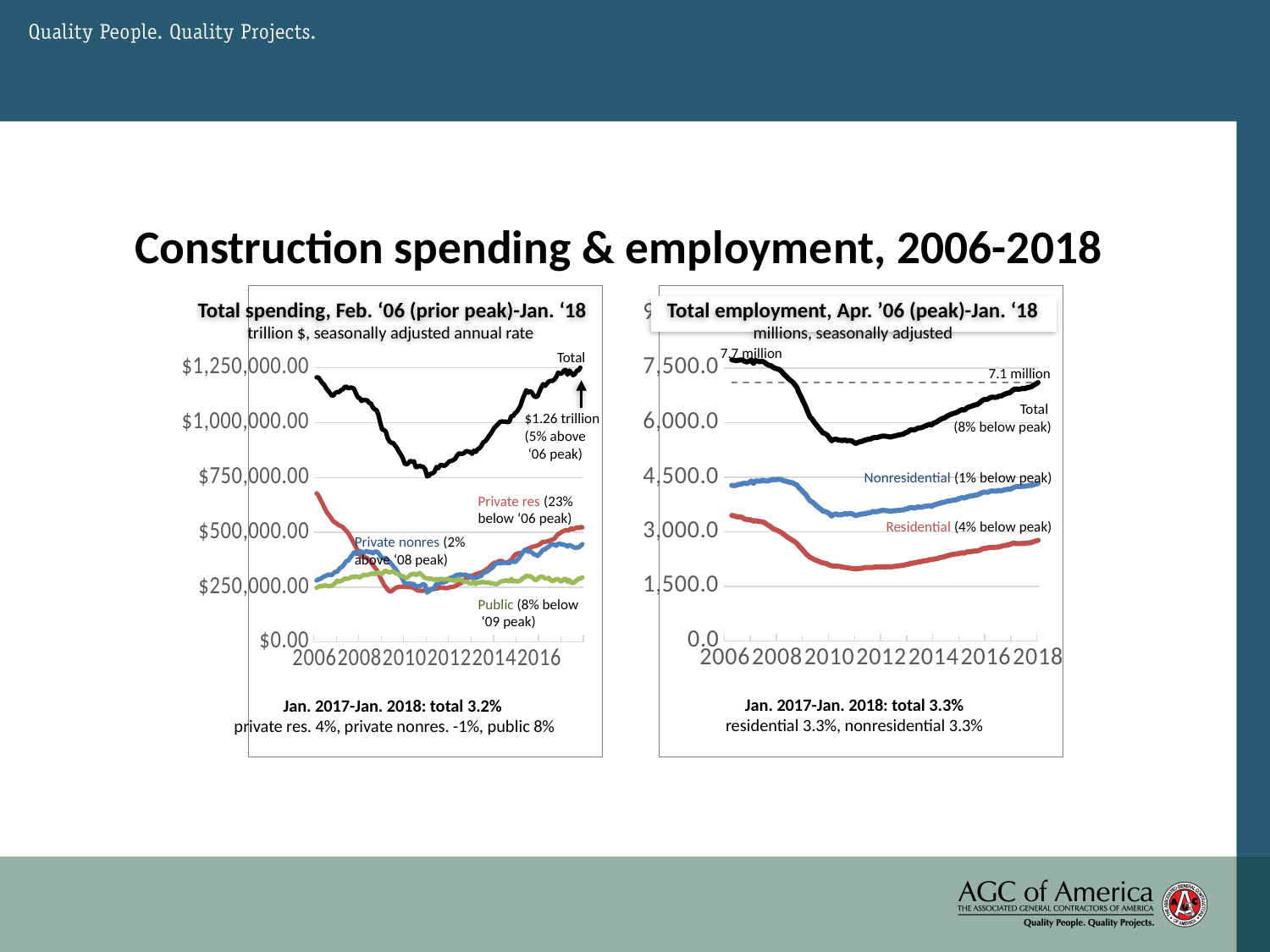
What kind of chart is the right chart, 'Total employment, Apr. '06 (peak)-Jan. '18'? Line chart How many lines are plotted in the right chart (Total employment)? 4 How many lines are plotted in the left chart (Total spending)? 4 In the right chart (Total employment), does the Total line rise or fall between 2006 and 2010? Fall In the right chart (Total employment), which line is higher at 2018, Nonresidential or Residential? Nonresidential What kind of chart is the left chart, 'Total spending, Feb. '06 (prior peak)-Jan. '18'? Line chart In the left chart (Total spending), is the Public line in 2016 greater or less than $500,000.00? less In the right chart (Total employment), is the Residential line at 2018 greater or less than 3,000.0? less In the right chart (Total employment), what was the peak employment value labelled at the start of the series? 7.7 million In the left chart (Total spending), how far is Private res spending from its '06 peak according to the label? 23% below '06 peak In the left chart (Total spending), what is the total spending value labelled at the end of the series? $1.26 trillion In the right chart (Total employment), what is the total employment value labelled at the end of the series in Jan. '18? 7.1 million